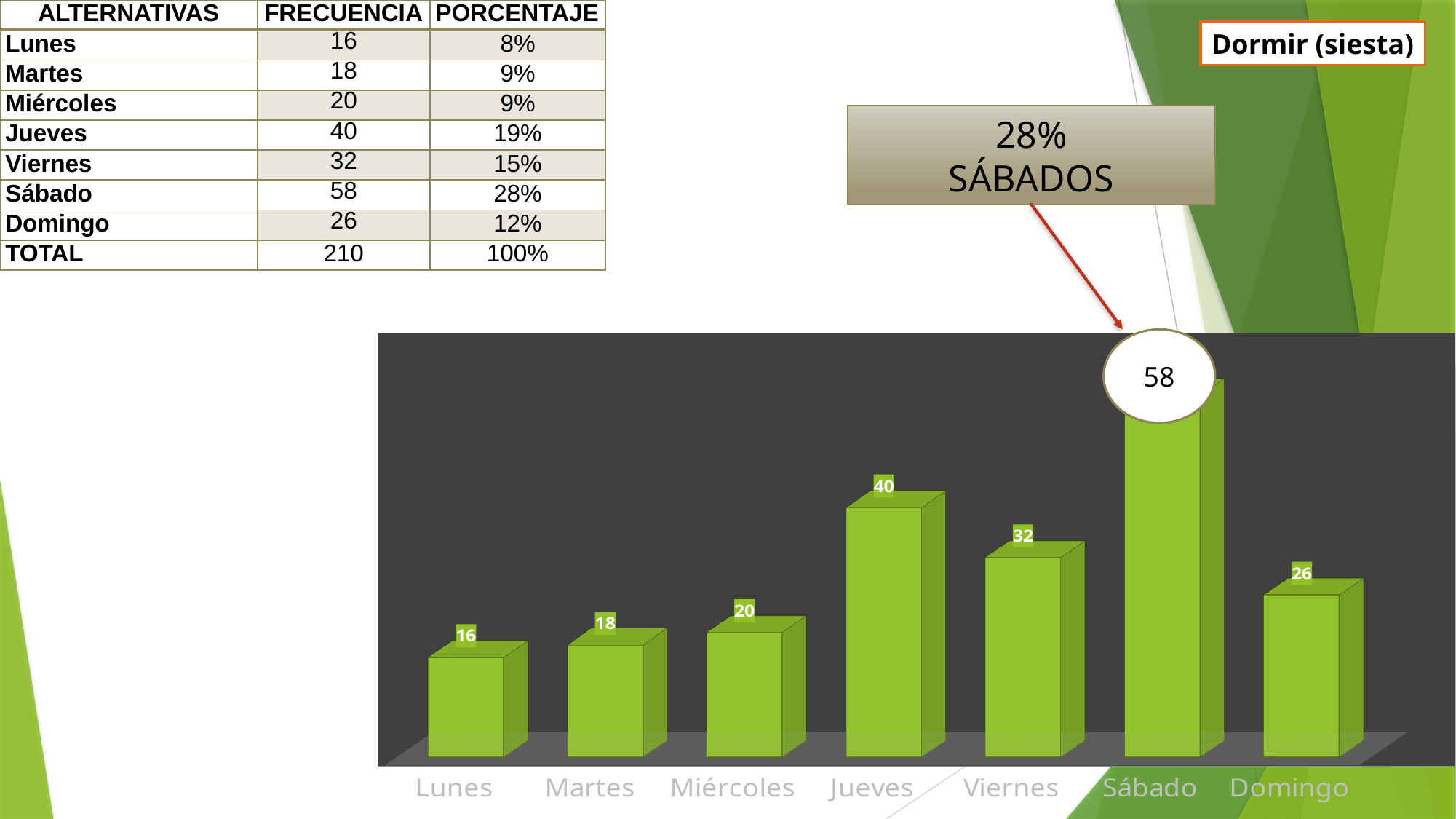
What is the difference between the values for Viernes and Martes? 14 Which is larger, the value for Viernes or the value for Domingo? Viernes Which day has the highest value in the bar chart? Sábado What is the difference between the values for Sábado and Jueves? 18 What percentage is shown in the callout box pointing to the Sábado bar? 28% What kind of chart is shown on the slide? bar chart What is the value for Jueves in the bar chart? 40 Which day has the lowest value in the bar chart? Lunes Do the values rise or fall from Lunes to Jueves? rise What is the value for Domingo in the bar chart? 26 What is the value for Miércoles in the bar chart? 20 How many categories are shown on the x axis of the bar chart? 7